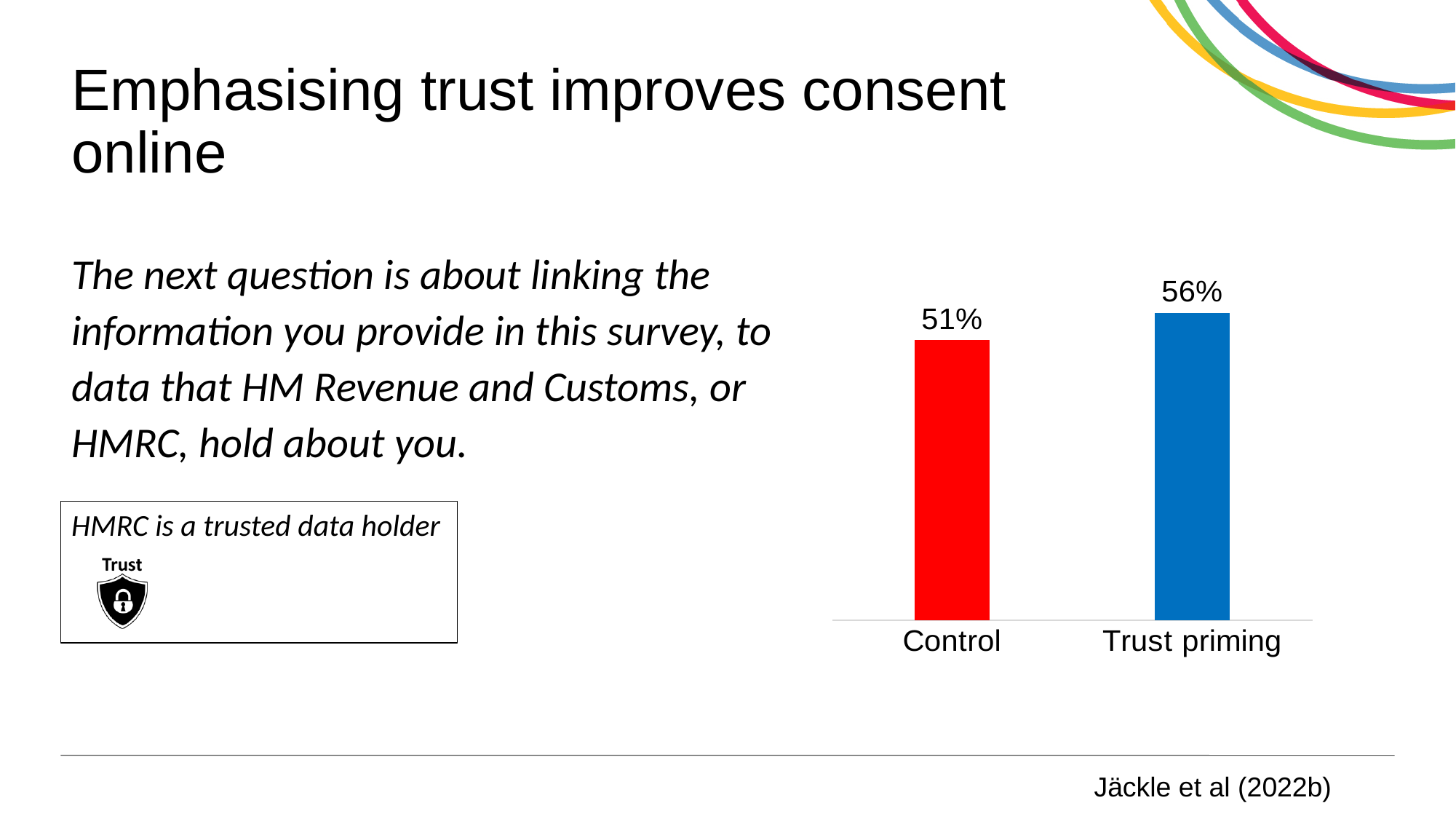
How many categories are shown in the chart? 2 What is the value for Trust priming? 56% Which category has the highest value? Trust priming What is the difference between the Trust priming and Control values? 5% Do the values rise or fall from Control to Trust priming? Rise Which is larger, the value for Control or the value for Trust priming? Trust priming What kind of chart is shown on the slide? Bar chart What is the value for Control? 51% What colour is the bar for Trust priming? Blue What colour is the bar for Control? Red Which category has the lowest value? Control